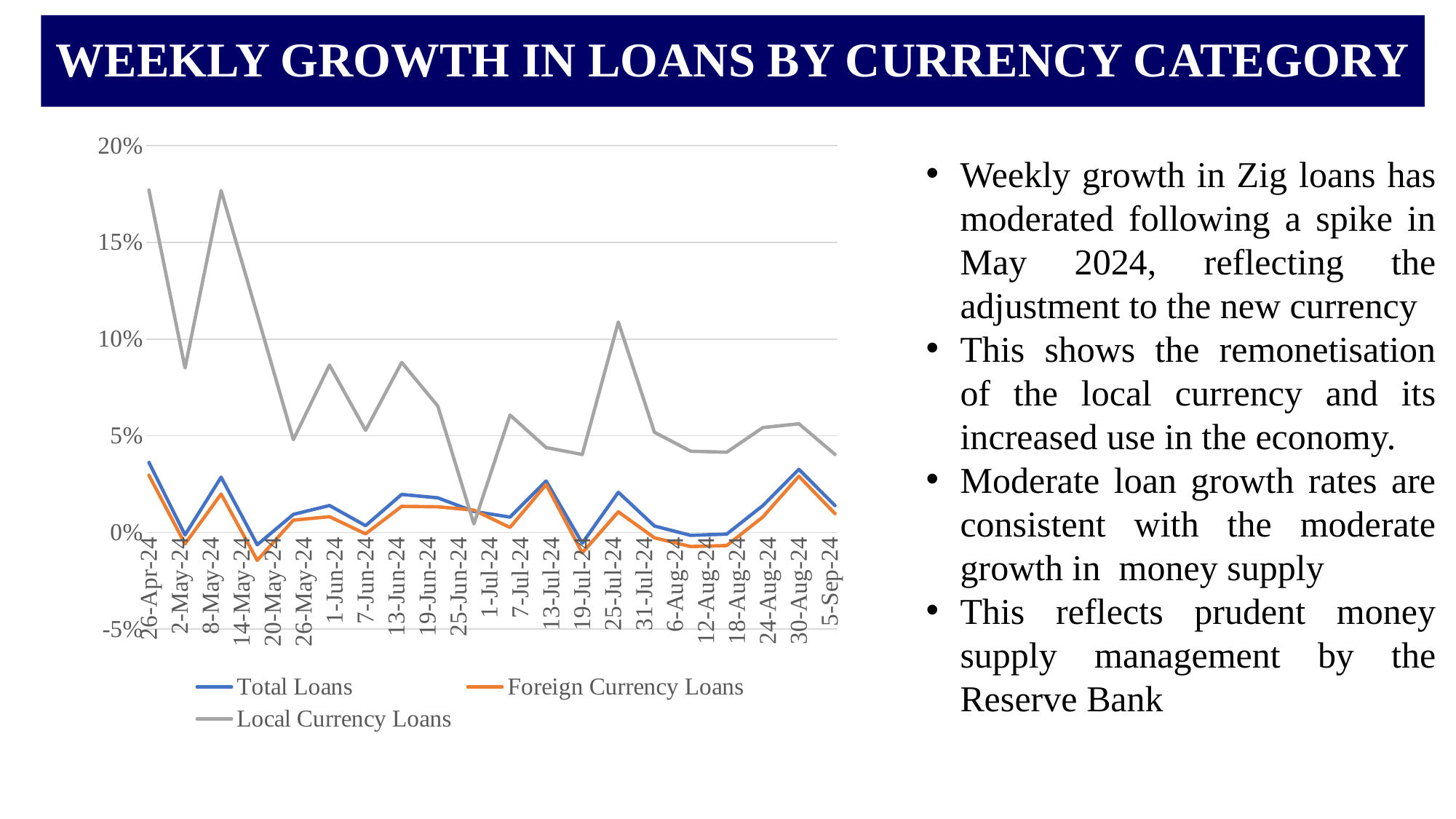
Is the value for Local Currency Loans on 25-Jul-24 greater or less than 10%? greater On which date is the Foreign Currency Loans series at its lowest? 14-May-24 Is the value for Local Currency Loans on 26-Apr-24 greater or less than 15%? greater What kind of chart is shown on the slide? line chart Is the value for Local Currency Loans on 25-Jun-24 greater or less than 5%? less How many series does the legend list? 3 Does the Local Currency Loans series rise or fall from 26-Apr-24 to 2-May-24? fall What colour is the Local Currency Loans line in the legend? grey On which date is the Local Currency Loans series at its lowest? 25-Jun-24 How many dates are shown on the x axis of the chart? 23 On 8-May-24, which is larger: Local Currency Loans or Foreign Currency Loans? Local Currency Loans